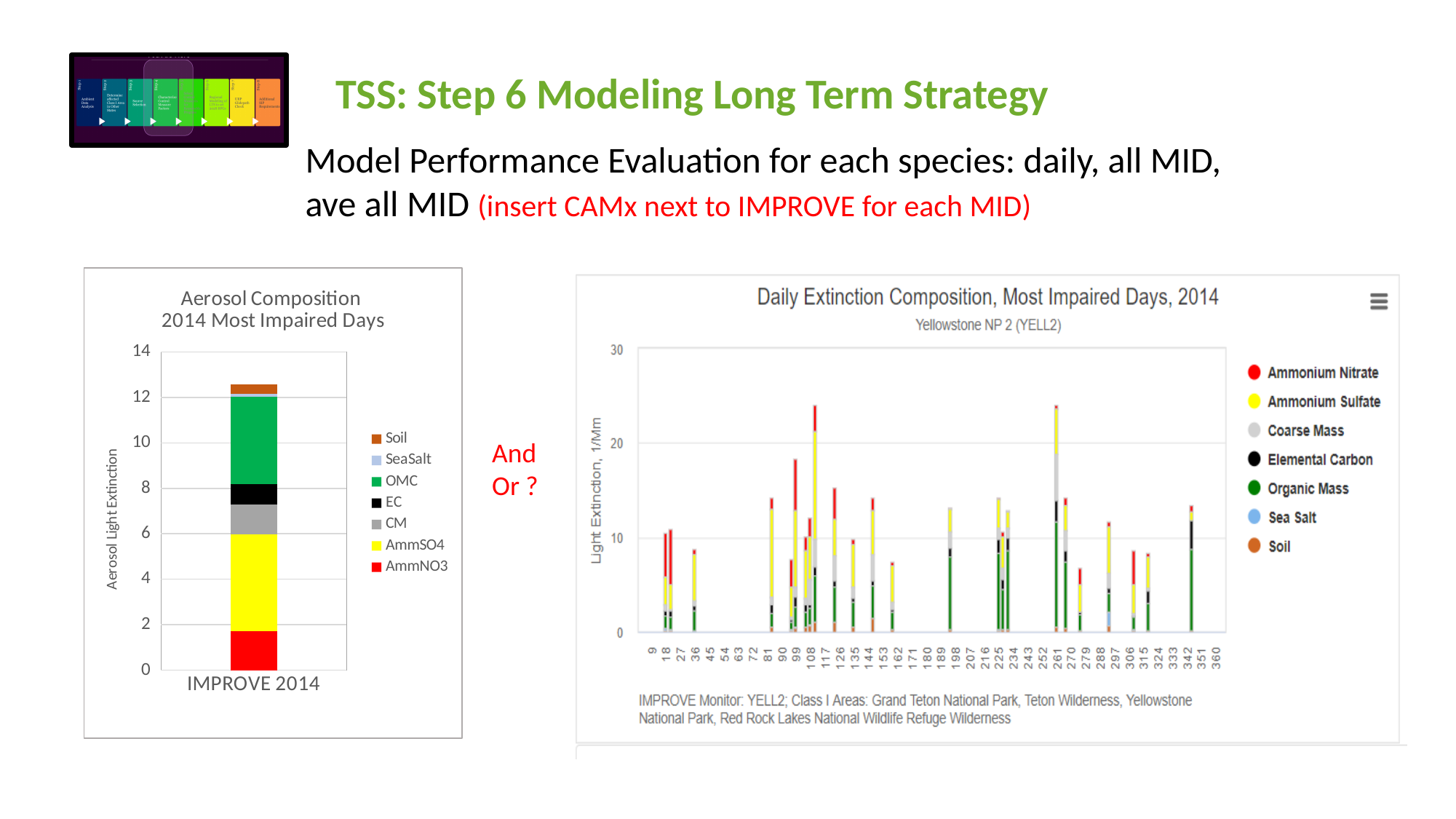
How many categories are shown on the x axis of the 'Aerosol Composition 2014 Most Impaired Days' chart? 1 In the 'Daily Extinction Composition, Most Impaired Days, 2014' chart, is the total bar at day 99 greater or less than 10? greater What is the y-axis title of the 'Aerosol Composition 2014 Most Impaired Days' chart? Aerosol Light Extinction In the 'Daily Extinction Composition, Most Impaired Days, 2014' chart, is the total bar at day 36 greater or less than 10? less What kind of chart is the 'Aerosol Composition 2014 Most Impaired Days' chart on the left? bar chart How many series does the legend of the 'Daily Extinction Composition, Most Impaired Days, 2014' chart list? 7 How many series does the legend of the 'Aerosol Composition 2014 Most Impaired Days' chart list? 7 In the 'Aerosol Composition 2014 Most Impaired Days' chart, which segment of the IMPROVE 2014 bar is larger, AmmSO4 or AmmNO3? AmmSO4 In the 'Aerosol Composition 2014 Most Impaired Days' chart, is the AmmNO3 value for IMPROVE 2014 greater or less than 2? less What kind of chart is the 'Daily Extinction Composition, Most Impaired Days, 2014' chart on the right? bar chart What site name is shown as the subtitle of the 'Daily Extinction Composition, Most Impaired Days, 2014' chart? Yellowstone NP 2 (YELL2)